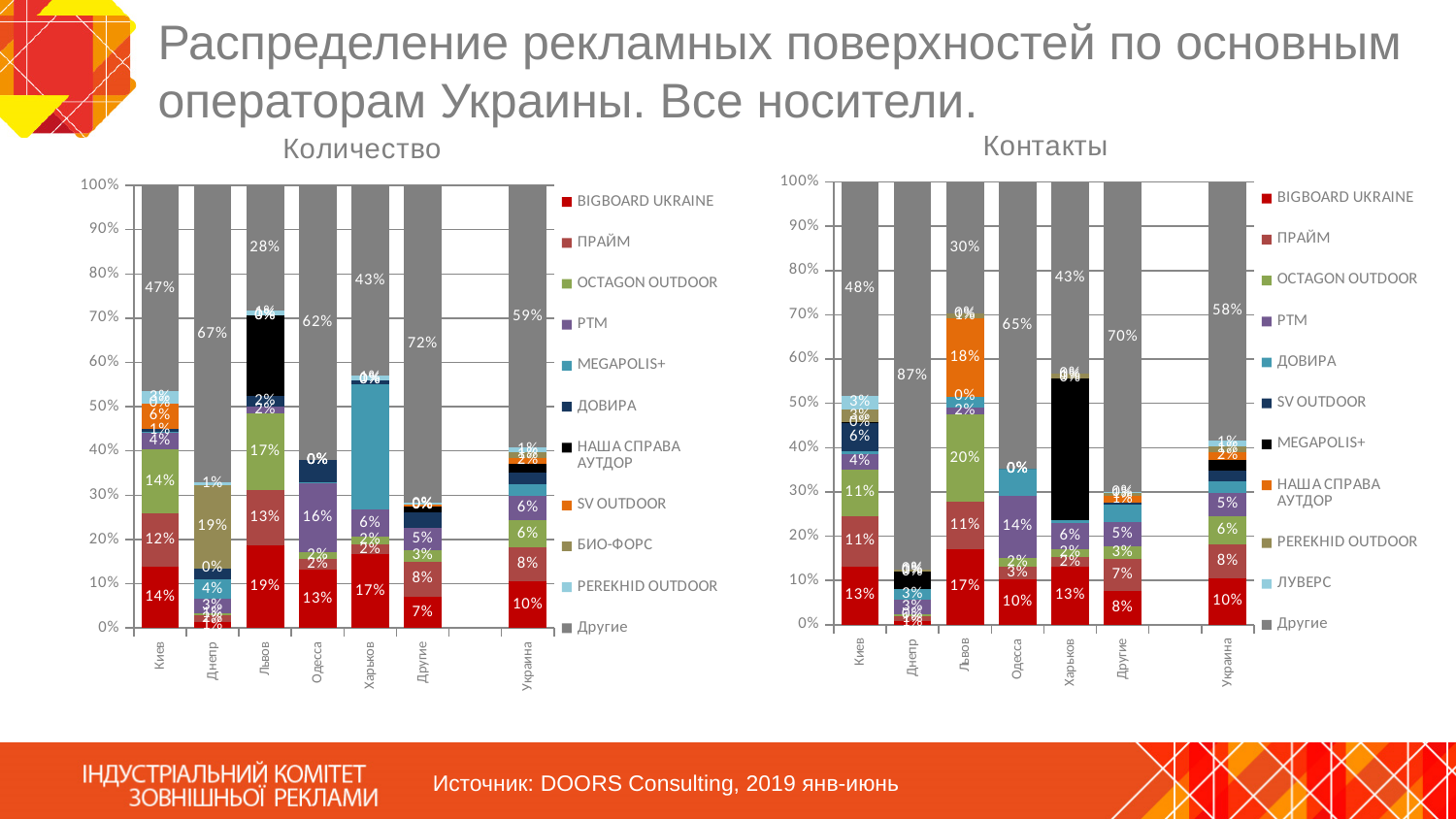
On the Количество chart, what is the value of BIGBOARD UKRAINE for Львов? 19% On the Контакты chart, what is the value of Другие for Днепр? 87% On the Количество chart, what is the difference between the Другие share for Одесса and for Львов? 34% On the Количество chart, is the Другие share for Харьков greater or less than 50%? less On the Контакты chart, which is larger: the BIGBOARD UKRAINE share for Львов or for Одесса? Львов How many categories are shown on the x axis of the Контакты chart? 7 On the Количество chart, what is the value of Другие for Днепр? 67% What type of chart is the Контакты chart? stacked bar chart On the Контакты chart, which category has the lowest Другие share? Львов On the Количество chart, which category has the highest Другие share? Другие How many series does the legend of the Количество chart list? 11 On the Контакты chart, what is the value of Другие for Украина? 58%